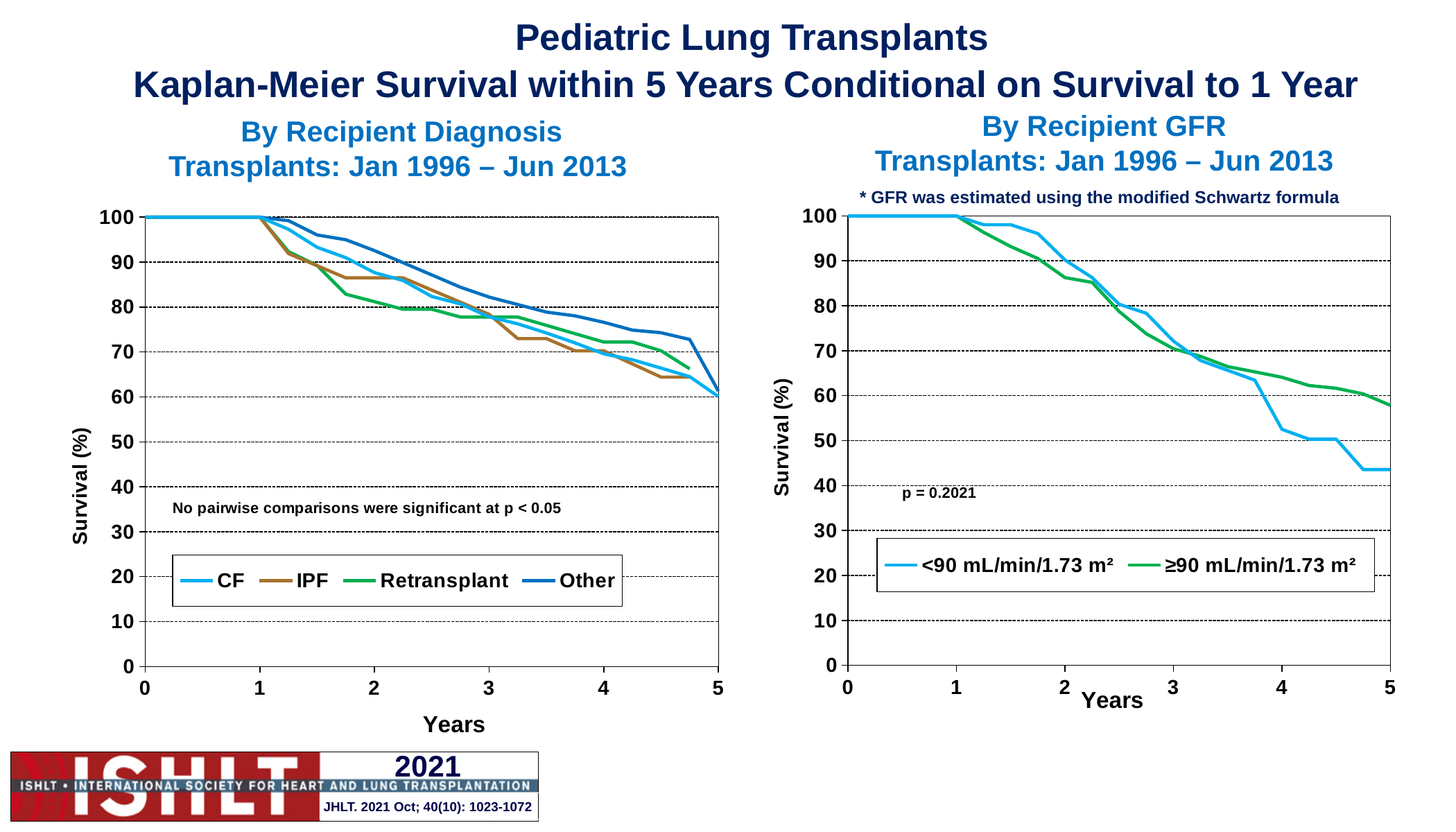
In the 'By Recipient GFR' chart, is the survival value for the <90 mL/min/1.73 m² group at year 5 greater or less than 50? less What p-value is printed on the 'By Recipient GFR' chart? p = 0.2021 In the 'By Recipient GFR' chart, is the survival value for the ≥90 mL/min/1.73 m² group at year 2 greater or less than 80? greater How many series does the legend of the 'By Recipient GFR' chart list? 2 What is the x-axis label of the 'By Recipient Diagnosis' chart? Years In the 'By Recipient GFR' chart, which group has higher survival at year 5, <90 mL/min/1.73 m² or ≥90 mL/min/1.73 m²? ≥90 mL/min/1.73 m² What kind of chart is the 'By Recipient Diagnosis' chart on the left? Line chart In the 'By Recipient GFR' chart, do the survival curves rise or fall as years increase? Fall In the 'By Recipient Diagnosis' chart, is the survival value for the Retransplant group at year 3 greater or less than 80? less How many series does the legend of the 'By Recipient Diagnosis' chart list? 4